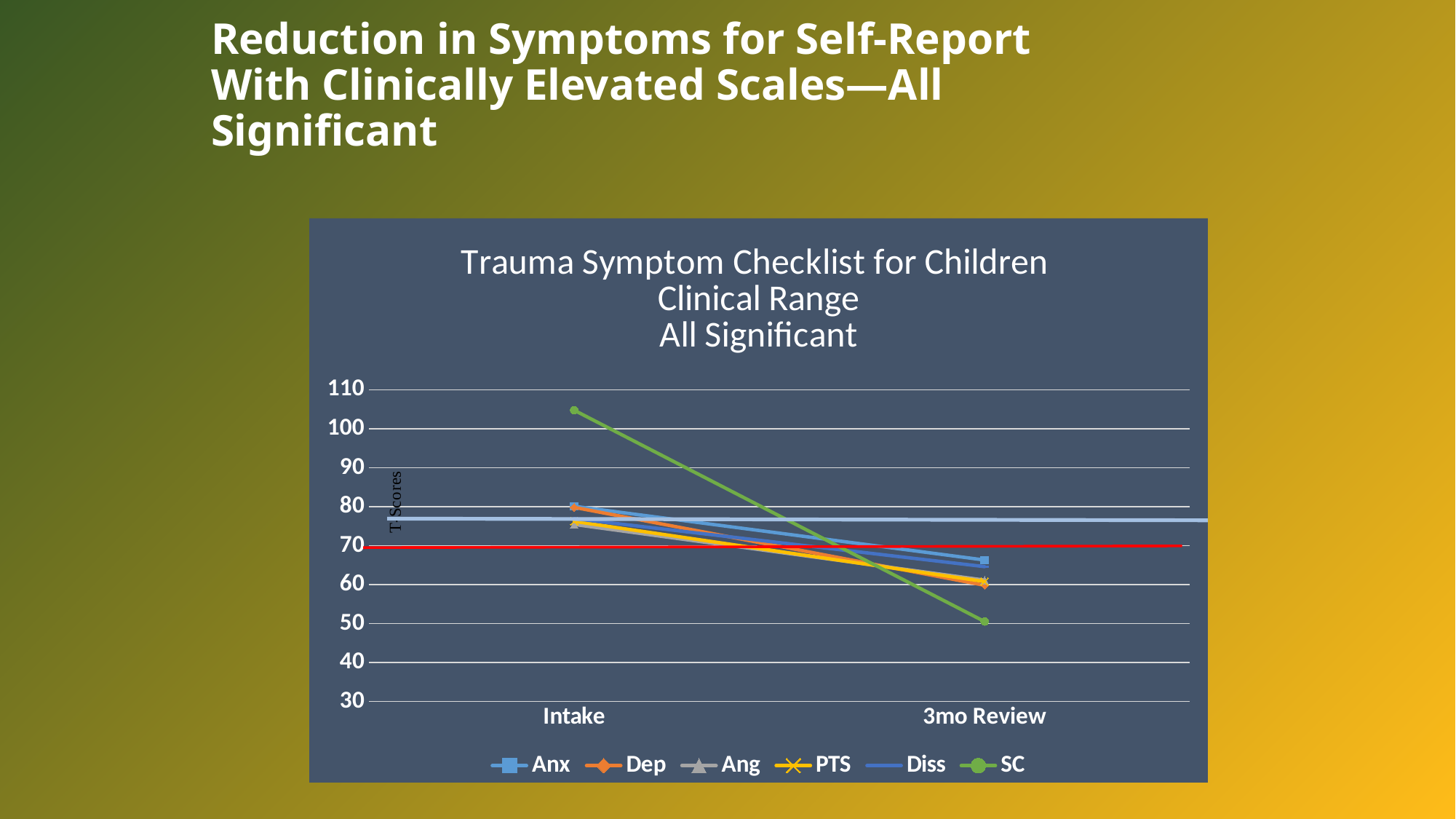
Which is larger at Intake, the value for SC or the value for Anx? SC How many series does the legend list? 6 Which series has the highest value at Intake? SC What is the label on the vertical axis of the chart? T Scores What kind of chart is shown on the slide? Line chart Which series has the lowest value at 3mo Review? SC Is the value for SC at Intake greater or less than 100? greater Do the series values rise or fall from Intake to 3mo Review? Fall How many categories are shown on the x axis? 2 Is the value for SC at 3mo Review greater or less than 60? less Is the value for Anx at 3mo Review greater or less than 70? less